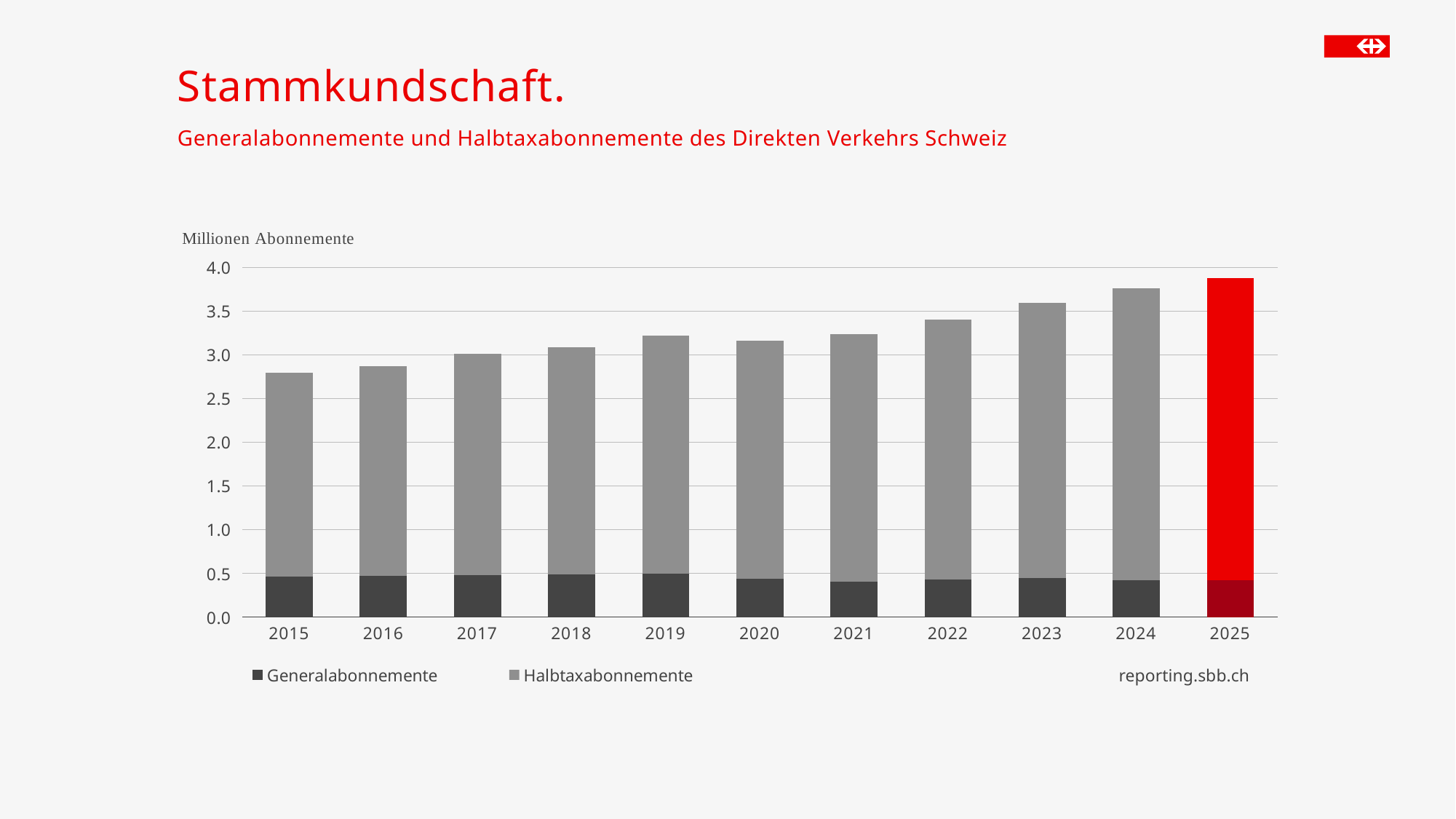
Which year has the highest total bar in the chart? 2025 How many years are shown on the x axis of the chart? 11 Which year has the lowest total bar in the chart? 2015 What kind of chart is shown on the slide? Stacked bar chart Is the total value for 2025 greater or less than 3.5? greater How many series does the chart legend list? 2 Is the total value for 2015 greater or less than 3.0? less Is the Generalabonnemente value for 2021 greater or less than 0.5? less Do the total values generally rise or fall from 2015 to 2025? rise What unit is given on the vertical axis label of the chart? Millionen Abonnemente Which year has the larger total bar, 2016 or 2018? 2018